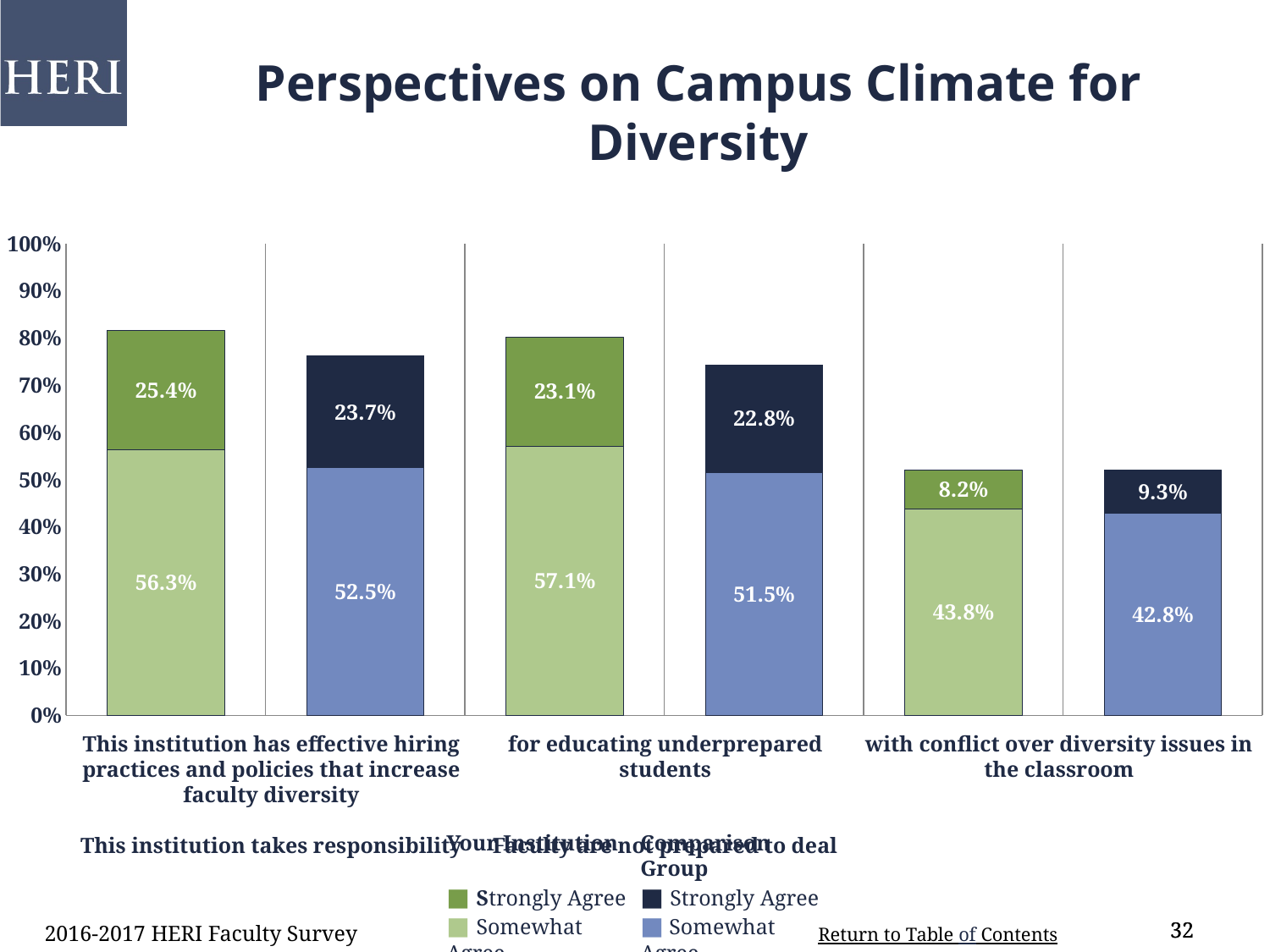
What percentage of the Comparison Group strongly agree with the statement about conflict over diversity issues in the classroom? 9.3% Which colour represents Strongly Agree for the Comparison Group in the legend? Dark navy How many statements (categories) are shown on the x axis of the chart? 3 What percentage of Your Institution faculty strongly agree that this institution has effective hiring practices and policies that increase faculty diversity? 25.4% Which has the larger Strongly Agree percentage for the statement about conflict over diversity issues in the classroom, Your Institution or the Comparison Group? Comparison Group What percentage of Your Institution faculty somewhat agree with the statement about educating underprepared students? 57.1% What kind of chart is shown on the slide? Stacked bar chart Which statement has the lowest Strongly Agree percentage for Your Institution? Faculty are not prepared to deal with conflict over diversity issues in the classroom What is the combined percentage (Strongly Agree plus Somewhat Agree) for Your Institution on the statement about effective hiring practices and policies that increase faculty diversity? 81.7% What is the difference between the Your Institution and Comparison Group Somewhat Agree percentages for the statement about educating underprepared students? 5.6% What is the combined percentage (Strongly Agree plus Somewhat Agree) for the Comparison Group on the statement about educating underprepared students? 74.3% What percentage of the Comparison Group somewhat agree that this institution has effective hiring practices and policies that increase faculty diversity? 52.5%